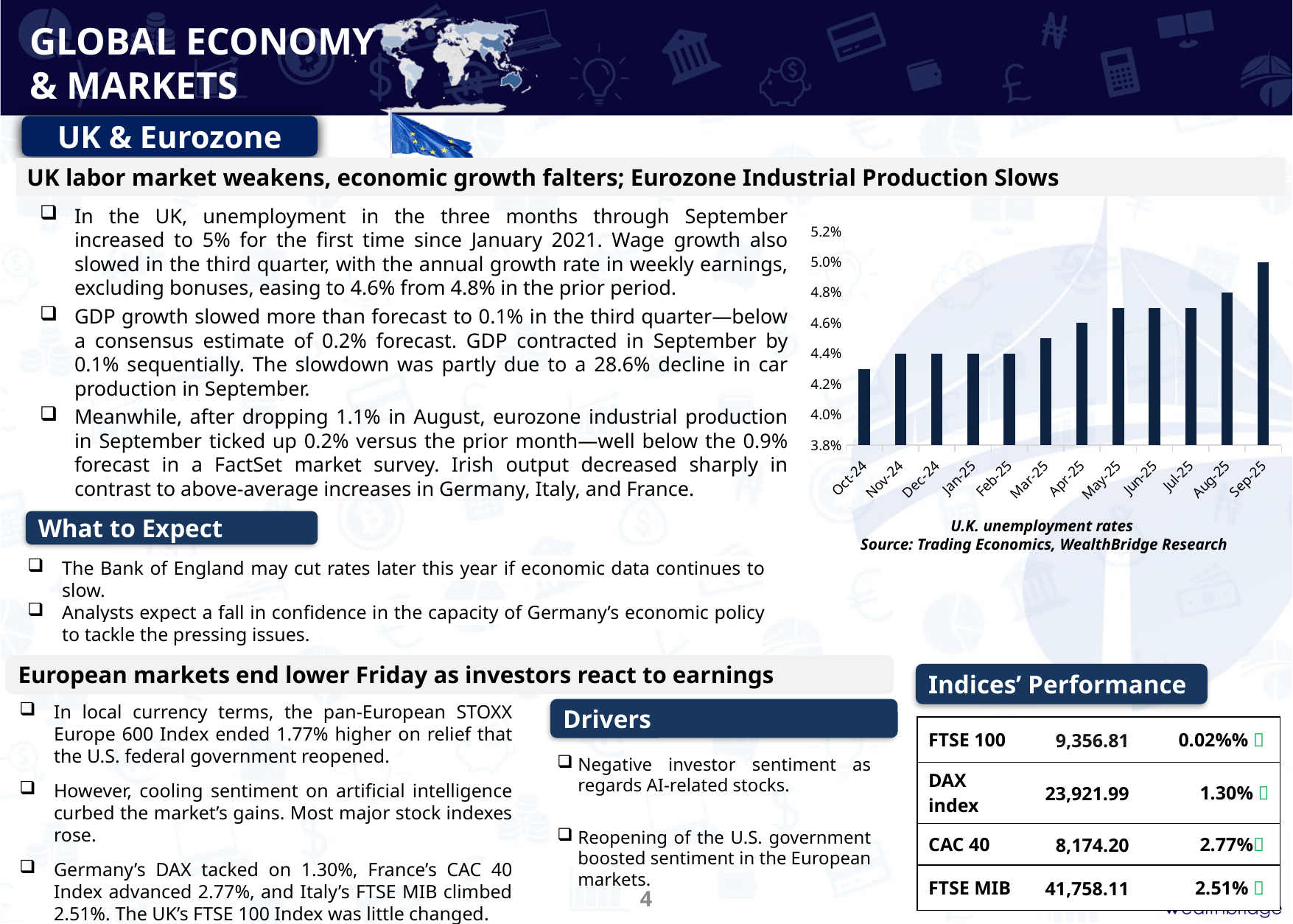
Which month has the highest unemployment rate in the U.K. unemployment rates chart? Sep-25 Which month has a higher U.K. unemployment rate, Oct-24 or Aug-25? Aug-25 Which month has the lowest unemployment rate in the U.K. unemployment rates chart? Oct-24 What is the source cited for the U.K. unemployment rates chart? Trading Economics, WealthBridge Research What kind of chart is used to show the U.K. unemployment rates? Bar chart Do the U.K. unemployment rates generally rise or fall from Oct-24 to Sep-25? Rise What is the U.K. unemployment rate shown for Sep-25? 5.0% How many months are plotted in the U.K. unemployment rates chart? 12 Is the U.K. unemployment rate for Oct-24 greater or less than 4.4%? less Is the U.K. unemployment rate for Apr-25 greater or less than 4.4%? greater What is the title of the chart on the slide? U.K. unemployment rates Is the U.K. unemployment rate for Aug-25 greater or less than 4.6%? greater